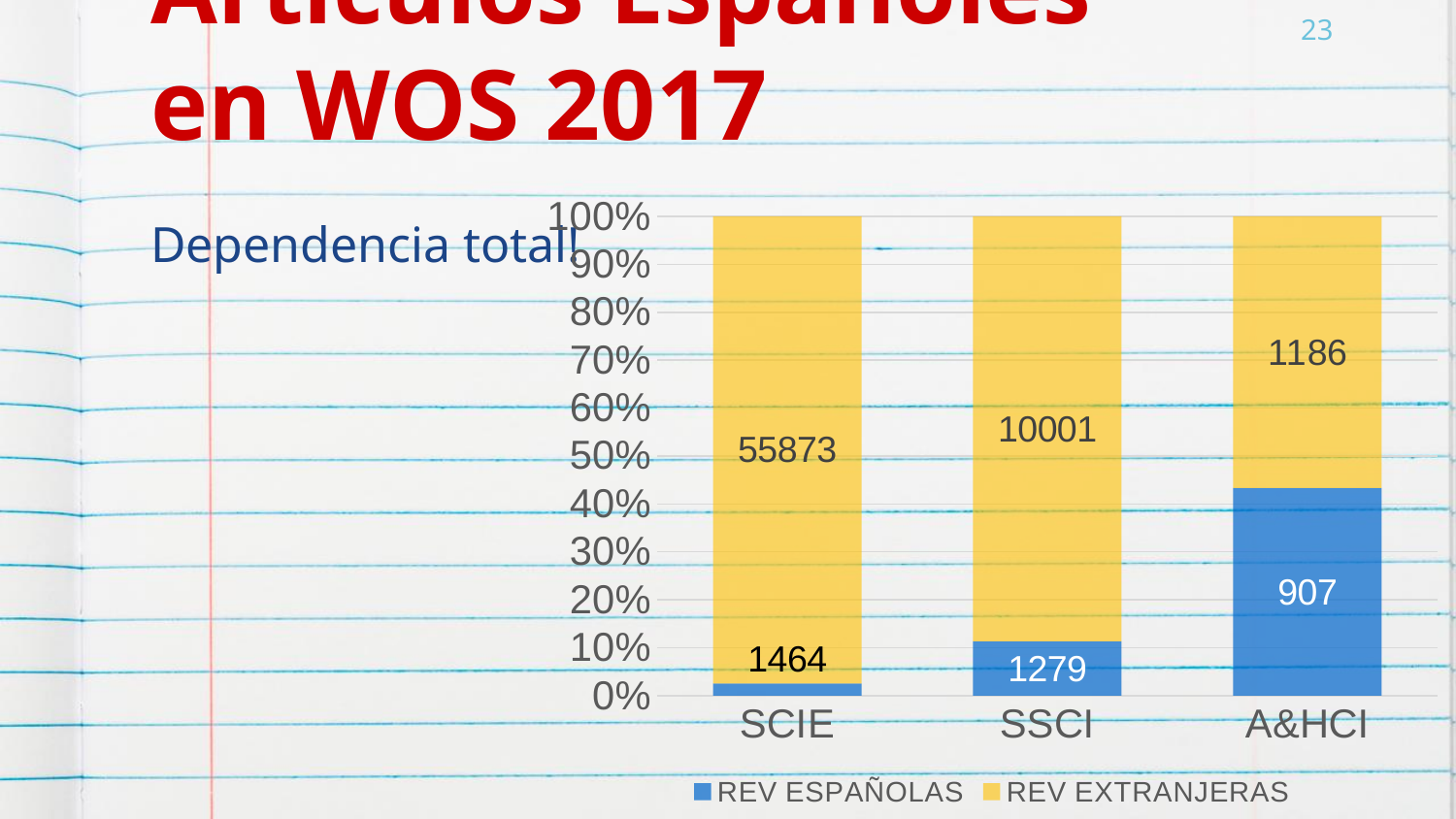
What kind of chart is shown on the slide? Stacked bar chart Which category has the lowest REV ESPAÑOLAS value? A&HCI How many series does the legend list? 2 What is the value for REV ESPAÑOLAS in the SSCI category? 1279 What is the difference between the REV EXTRANJERAS and REV ESPAÑOLAS values for A&HCI? 279 Is the REV ESPAÑOLAS share of the A&HCI bar greater or less than 40%? greater What is the value for REV ESPAÑOLAS in the A&HCI category? 907 Which is larger: the REV ESPAÑOLAS value for SCIE or for SSCI? SCIE How many categories are shown on the x axis? 3 What is the value for REV EXTRANJERAS in the SSCI category? 10001 Which category has the highest REV EXTRANJERAS value? SCIE What is the value for REV EXTRANJERAS in the SCIE category? 55873